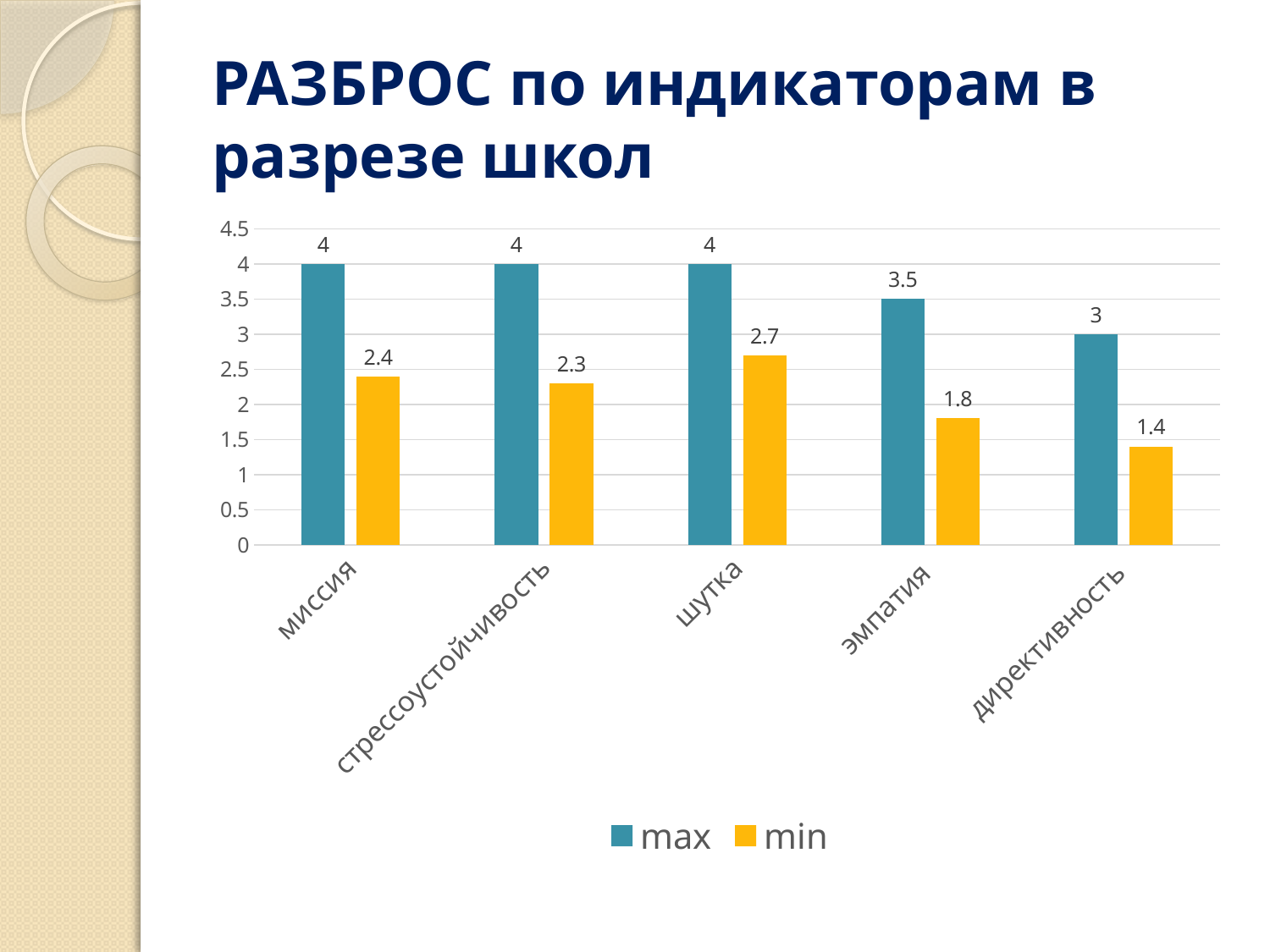
Which category has the highest min value? шутка What is the max value for миссия? 4 How many series does the legend list? 2 What is the difference between the max and min values for эмпатия? 1.7 What is the min value for шутка? 2.7 Which category has the lowest min value? директивность How many categories are shown on the x axis? 5 Which is larger, the min value for миссия or the min value for стрессоустойчивость? миссия What colour are the bars for the min series? yellow What kind of chart is shown on the slide? bar chart What is the min value for эмпатия? 1.8 What is the max value for директивность? 3